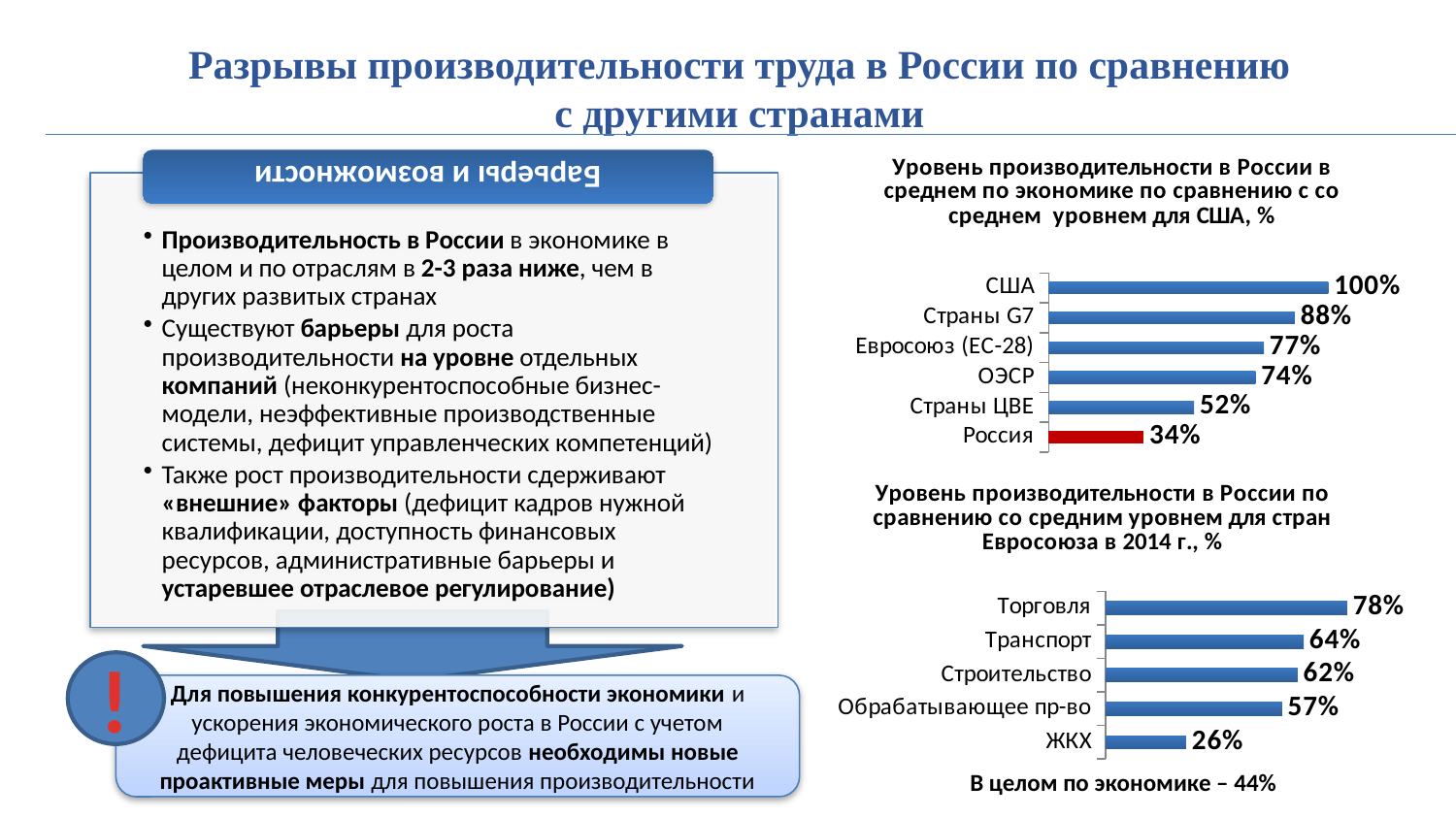
In the bottom chart (productivity compared with the EU average in 2014), which is larger: Транспорт or Обрабатывающее пр-во? Транспорт In the top chart (productivity level compared with the USA), what is the value for Страны G7? 88% In the top chart (productivity level compared with the USA), which bar is coloured red? Россия In the top chart (productivity level compared with the USA), what is the difference between Евросоюз (ЕС-28) and Россия? 43% What type of chart is the bottom chart (productivity compared with the EU average in 2014)? Bar chart In the bottom chart (productivity compared with the EU average in 2014), which category has the highest value? Торговля In the bottom chart (productivity compared with the EU average in 2014), what is the value for Торговля? 78% In the top chart (productivity level compared with the USA), which category has the lowest value? Россия In the top chart (productivity level compared with the USA), what is the value for Россия? 34% In the bottom chart (productivity compared with the EU average in 2014), what is the value for ЖКХ? 26% In the top chart (productivity level compared with the USA), how many categories are shown? 6 In the bottom chart (productivity compared with the EU average in 2014), what is the difference between Торговля and ЖКХ? 52%